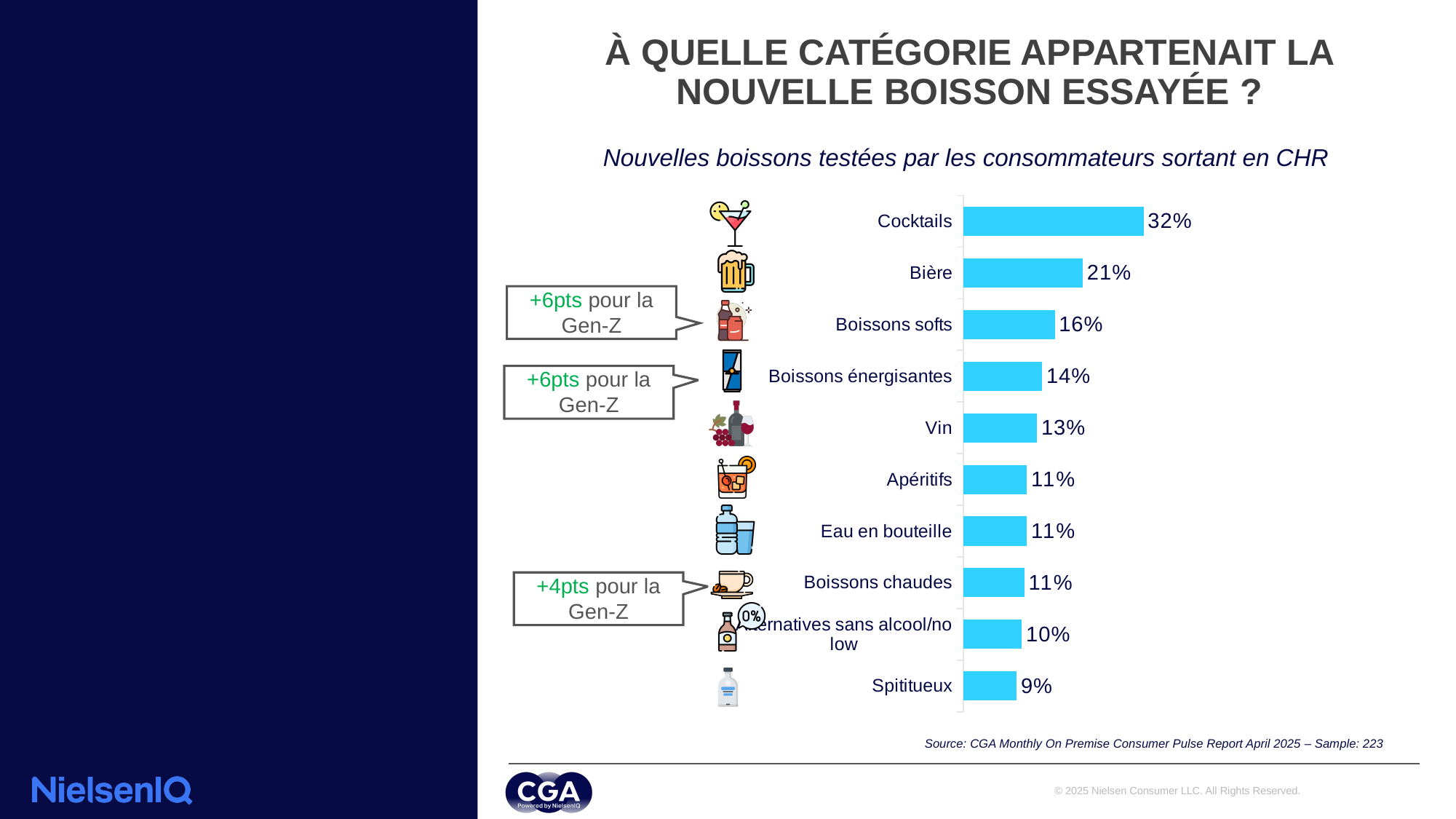
Which is larger, the value for Bière or the value for Boissons softs? Bière What is the value for Bière? 21% Which category has the lowest value? Spititueux What is the difference between the values for Cocktails and Bière? 11% What is the value for Boissons énergisantes? 14% What kind of chart is shown on the slide? Bar chart What is the subtitle shown above the chart? Nouvelles boissons testées par les consommateurs sortant en CHR What is the value for Cocktails? 32% Which category has the highest value? Cocktails How many categories are shown in the chart? 10 What is the value for Spiritueux? 9% What is the difference between the values for Boissons softs and Vin? 3%